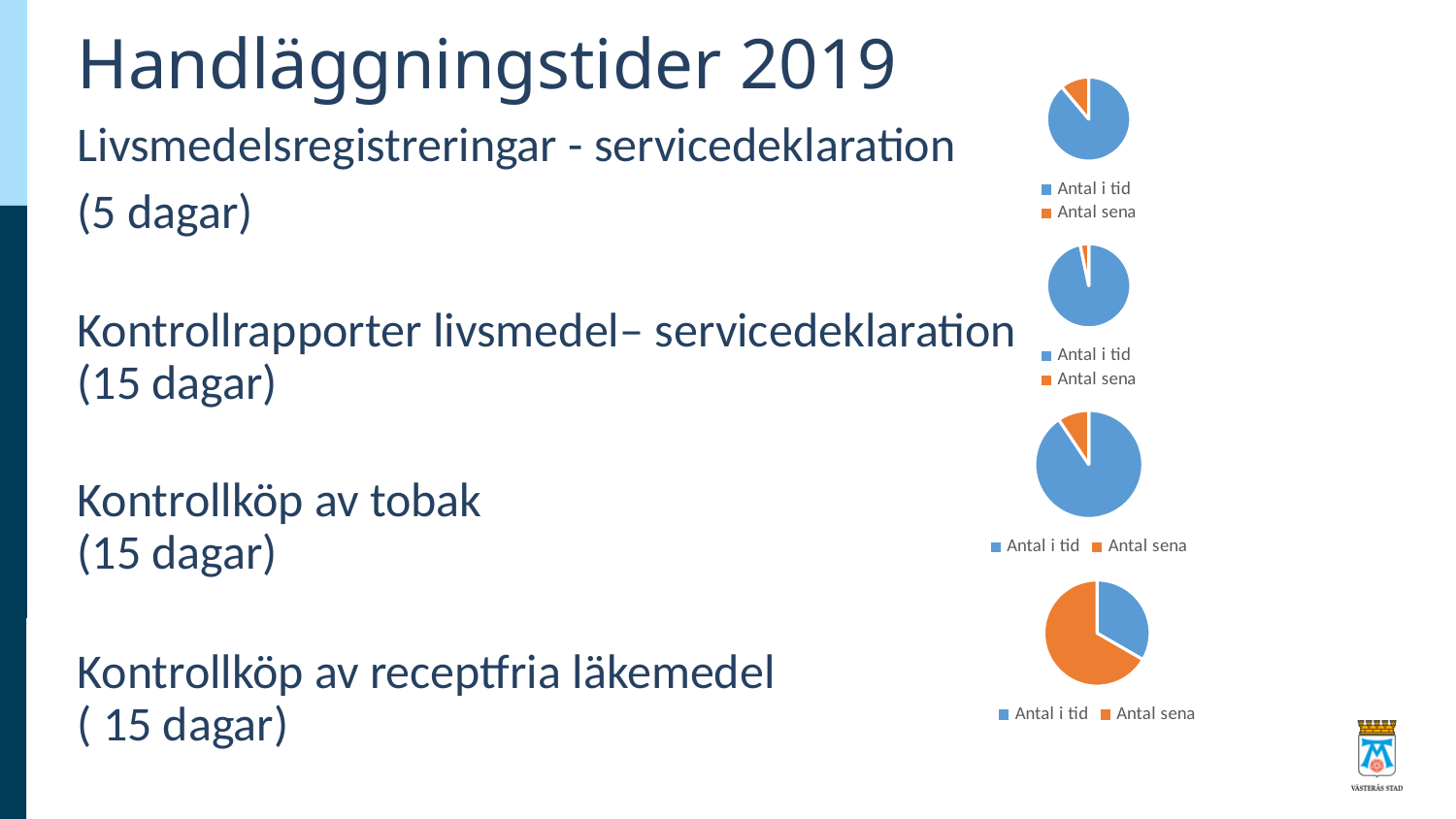
In the bottom pie chart, which category has the smallest slice? Antal i tid What are the two legend entries of the bottom pie chart? Antal i tid, Antal sena Which of the four pie charts has the smallest share for Antal sena? The second pie chart from the top In the bottom pie chart, which slice is larger, Antal i tid or Antal sena? Antal sena What colour represents Antal sena in the pie charts? Orange How many pie charts are shown on the slide? 4 In the third pie chart from the top, which slice is larger, Antal i tid or Antal sena? Antal i tid How many series does the legend of the top pie chart list? 2 What kind of chart is the top chart on the right side of the slide? Pie chart